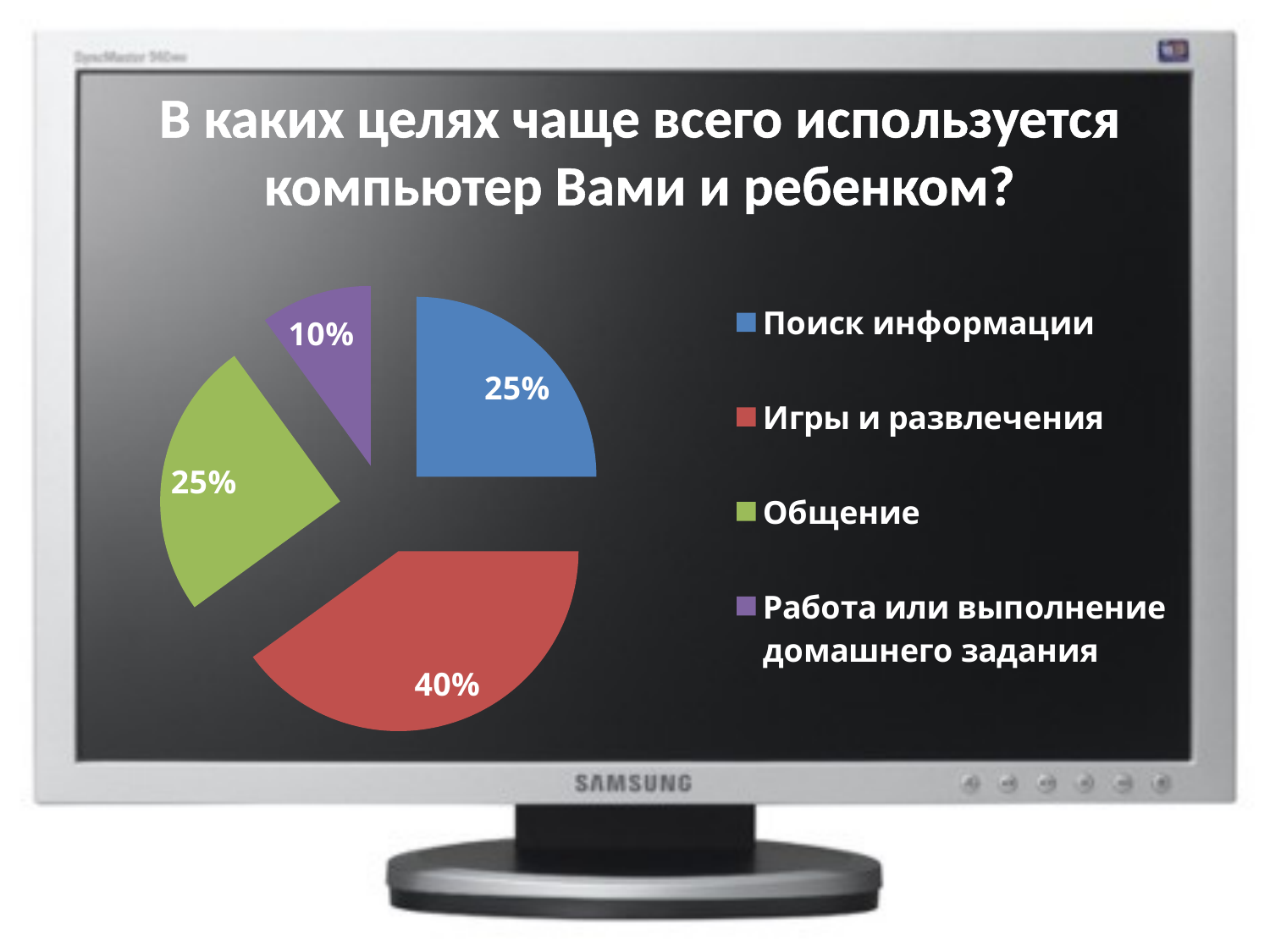
What is the title of the chart? В каких целях чаще всего используется компьютер Вами и ребенком? What share of the pie does "Игры и развлечения" take? 40% What is the value shown for "Работа или выполнение домашнего задания"? 10% Which category has the smallest slice of the pie? Работа или выполнение домашнего задания What kind of chart is shown on the slide? pie chart What is the value shown for "Поиск информации"? 25% Which category has the largest slice of the pie? Игры и развлечения Which is larger, the value for "Поиск информации" or the value for "Работа или выполнение домашнего задания"? Поиск информации What is the difference between the values for "Игры и развлечения" and "Общение"? 15% What is the value shown for "Общение"? 25% How many categories does the pie chart have? 4 What colour is the slice for "Общение"? green